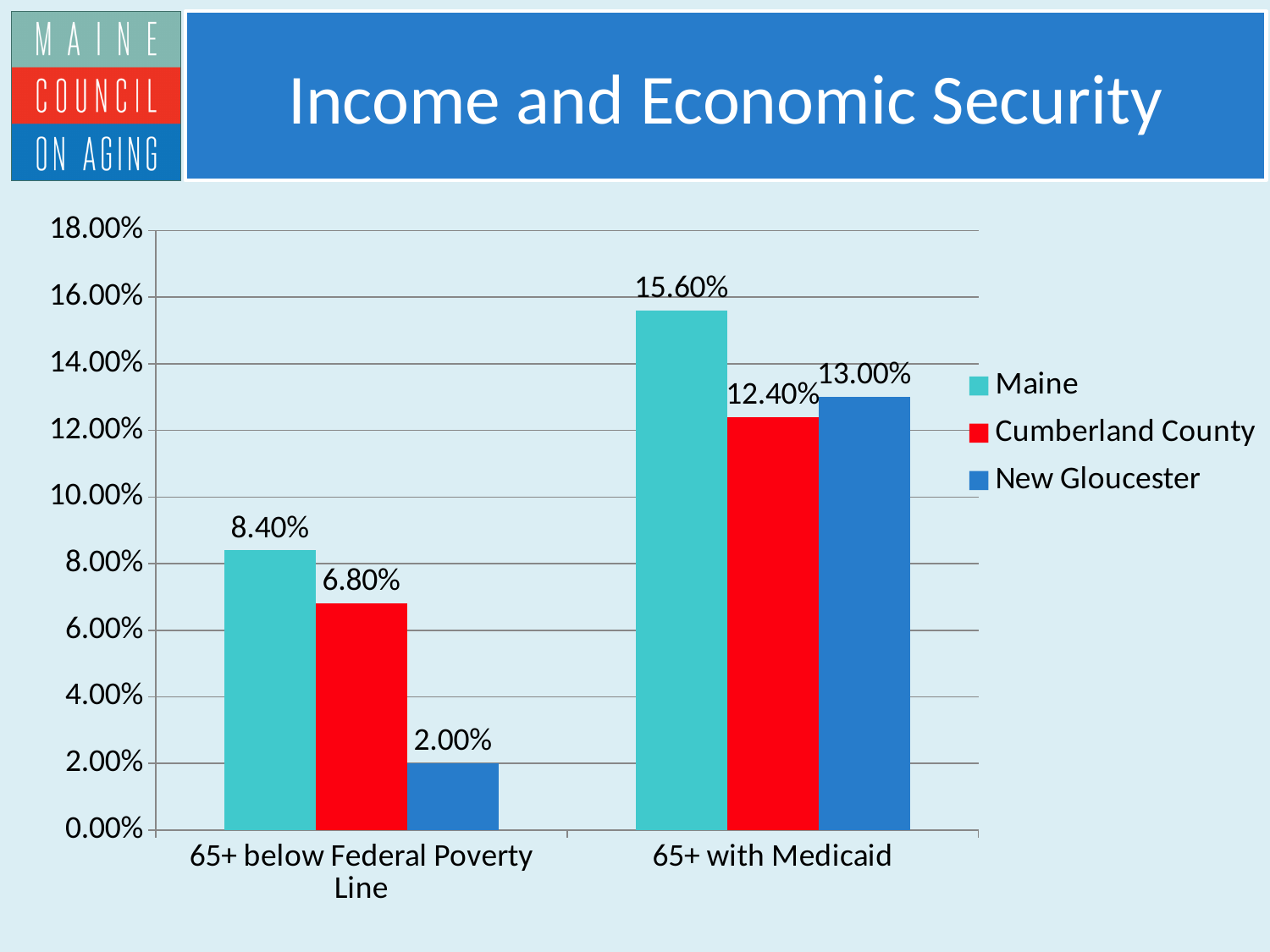
What is the difference between the Maine and Cumberland County values in the '65+ below Federal Poverty Line' category? 1.60% Which is larger: the New Gloucester value for '65+ with Medicaid' or the Cumberland County value for '65+ with Medicaid'? New Gloucester How many series does the legend list? 3 Is the value for Cumberland County in the '65+ below Federal Poverty Line' category greater or less than 8.00%? less What is the value for Cumberland County in the '65+ with Medicaid' category? 12.40% What is the difference between the Maine and New Gloucester values in the '65+ with Medicaid' category? 2.60% What is the value for Maine in the '65+ below Federal Poverty Line' category? 8.40% Which series has the highest value in the '65+ with Medicaid' category? Maine What kind of chart is shown on the slide? bar chart What is the value for New Gloucester in the '65+ with Medicaid' category? 13.00% Which series has the lowest value in the '65+ below Federal Poverty Line' category? New Gloucester How many categories are shown on the x axis? 2